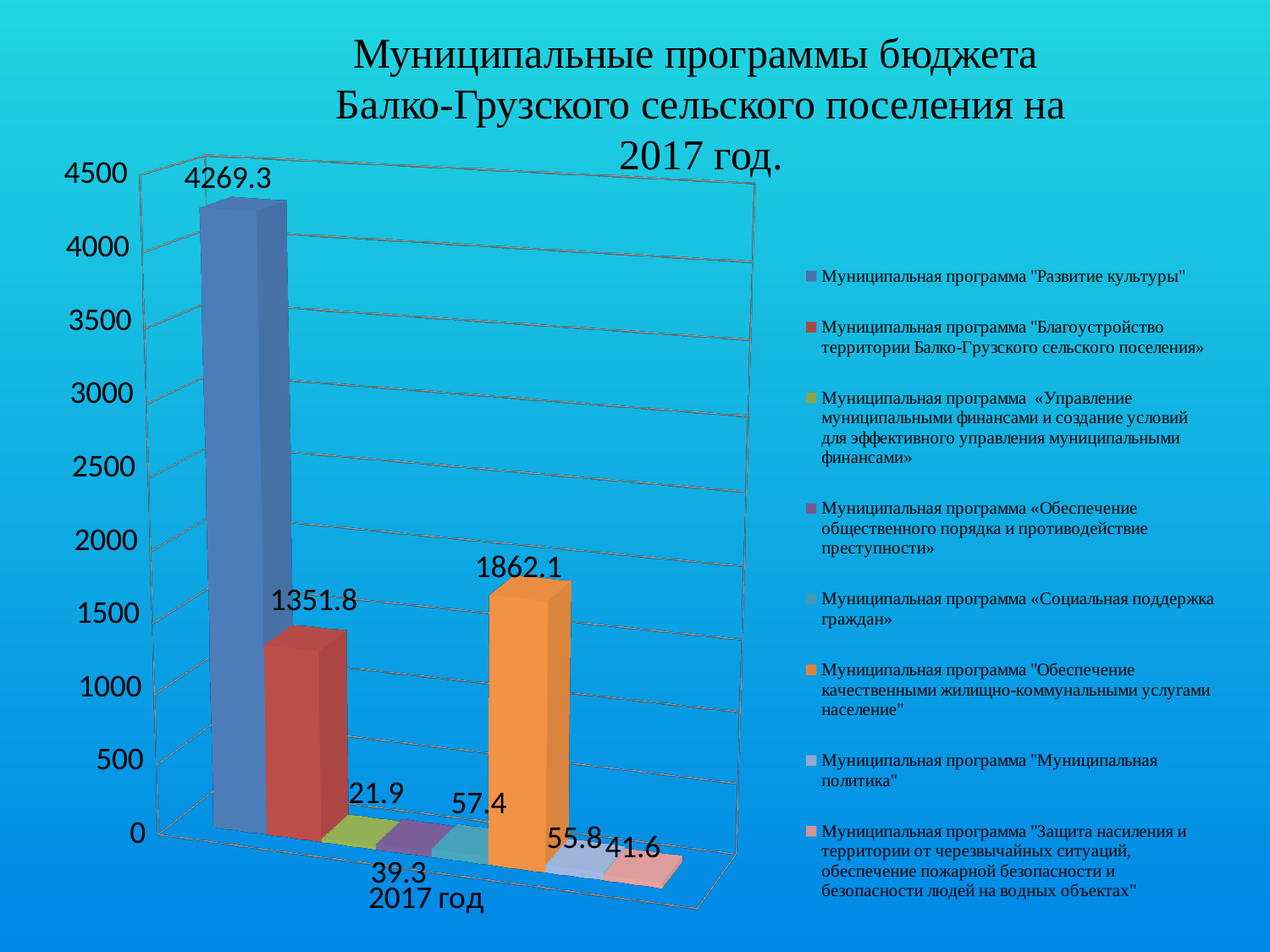
What is the value for the series Муниципальная программа "Обеспечение качественными жилищно-коммунальными услугами население"? 1862.1 How many series does the legend list? 8 What is the difference between the values for Муниципальная программа "Развитие культуры" and Муниципальная программа "Обеспечение качественными жилищно-коммунальными услугами население"? 2407.2 What kind of chart is shown on the slide? bar chart What is the value for the series Муниципальная программа "Муниципальная политика"? 55.8 Which series has the lowest value? Муниципальная программа «Управление муниципальными финансами и создание условий для эффективного управления муниципальными финансами» What is the category label shown on the x axis? 2017 год Which is larger: the value for Муниципальная программа "Благоустройство территории Балко-Грузского сельского поселения» or the value for Муниципальная программа "Обеспечение качественными жилищно-коммунальными услугами население"? Муниципальная программа "Обеспечение качественными жилищно-коммунальными услугами население" What is the value for the series Муниципальная программа "Развитие культуры"? 4269.3 Which series has the highest value? Муниципальная программа "Развитие культуры" What is the value for the series Муниципальная программа "Благоустройство территории Балко-Грузского сельского поселения»? 1351.8 Is the value for Муниципальная программа "Развитие культуры" greater or less than 4000? greater